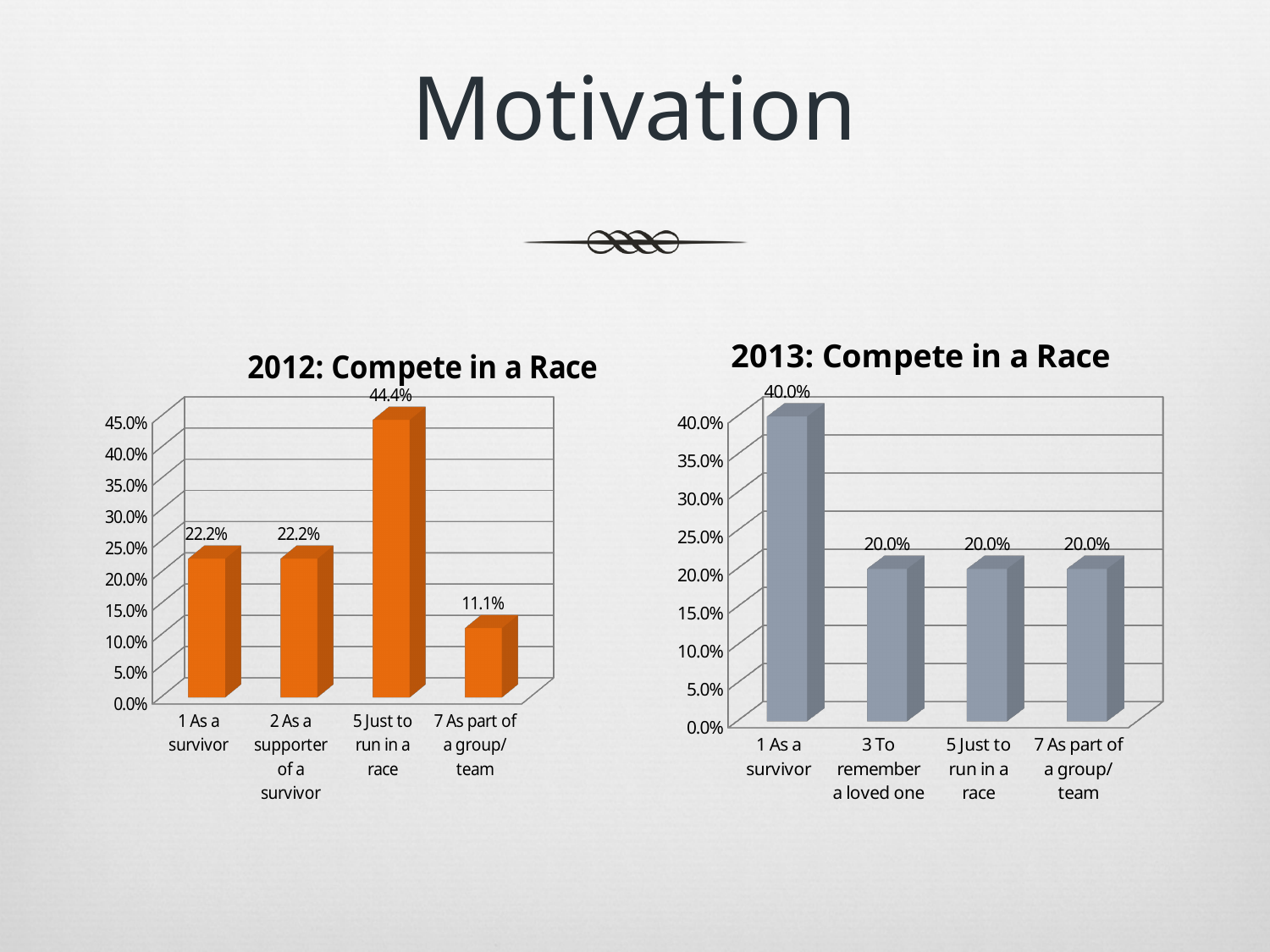
In the '2012: Compete in a Race' chart, which category has the lowest value? 7 As part of a group/ team In the '2013: Compete in a Race' chart, what is the difference between '1 As a survivor' and '5 Just to run in a race'? 20.0% In the '2012: Compete in a Race' chart, what is the value for '7 As part of a group/ team'? 11.1% In the '2013: Compete in a Race' chart, what is the value for '3 To remember a loved one'? 20.0% Which is larger: '1 As a survivor' in the 2012 chart or '1 As a survivor' in the 2013 chart? 2013 What kind of chart is the '2012: Compete in a Race' chart? Bar chart In the '2012: Compete in a Race' chart, which category has the highest value? 5 Just to run in a race In the '2013: Compete in a Race' chart, what is the value for '1 As a survivor'? 40.0% In the '2012: Compete in a Race' chart, what is the difference between '5 Just to run in a race' and '1 As a survivor'? 22.2% In the '2013: Compete in a Race' chart, which category has the highest value? 1 As a survivor In the '2012: Compete in a Race' chart, what is the value for '5 Just to run in a race'? 44.4% How many categories are shown in the '2013: Compete in a Race' chart? 4